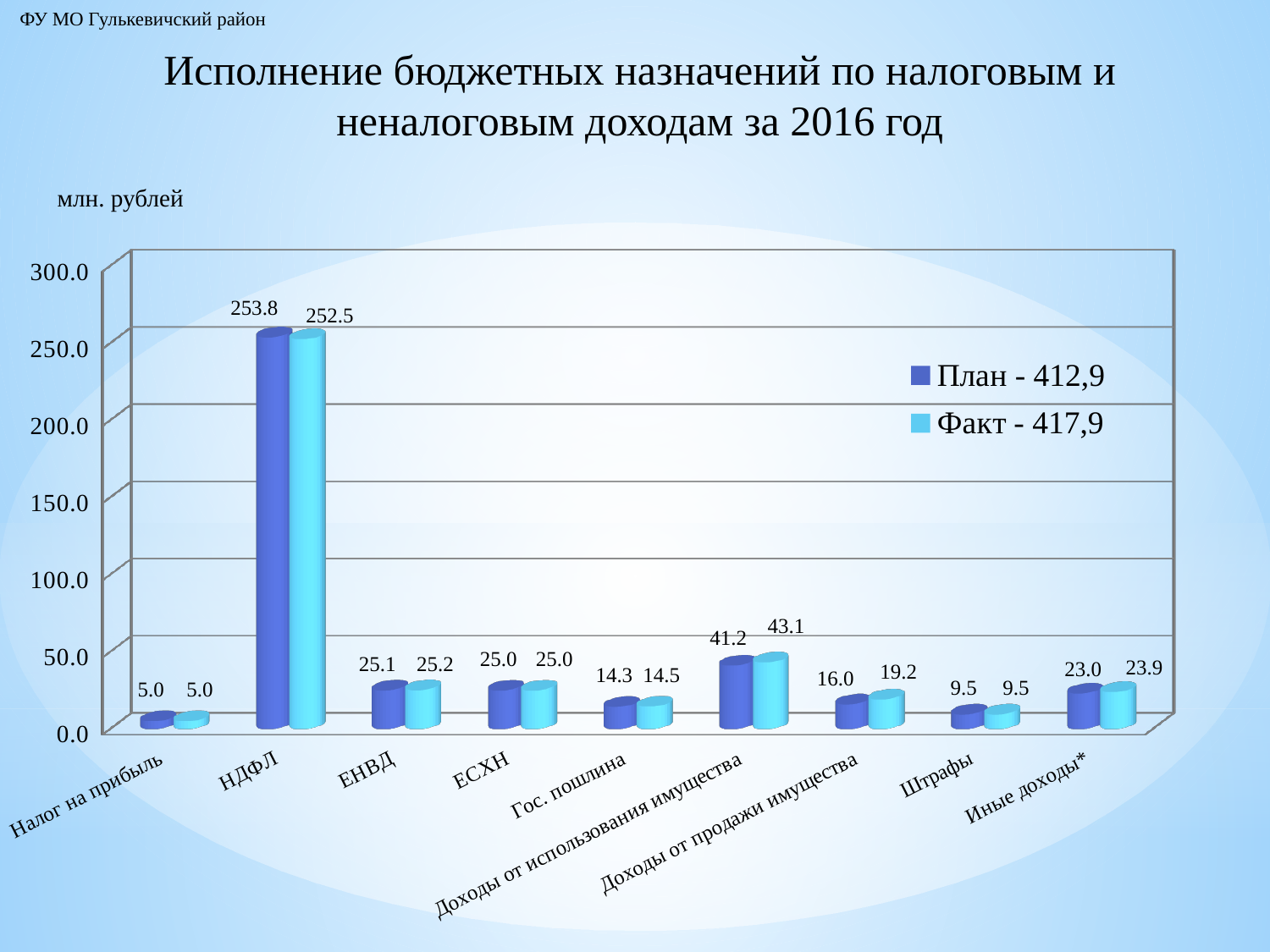
What unit is indicated above the chart? млн. рублей How many categories are shown on the x axis? 9 Which category has the highest Факт value? НДФЛ What is the difference between the Факт and План values for Доходы от использования имущества? 1.9 Which is larger for НДФЛ, the План value or the Факт value? План Which category has the lowest План value? Налог на прибыль What kind of chart is shown on the slide? bar chart What is the План value for НДФЛ? 253.8 Is the Факт value for НДФЛ greater or less than 200.0? greater How many series does the legend list? 2 What is the Факт value for Гос. пошлина? 14.5 What is the Факт value for Доходы от продажи имущества? 19.2